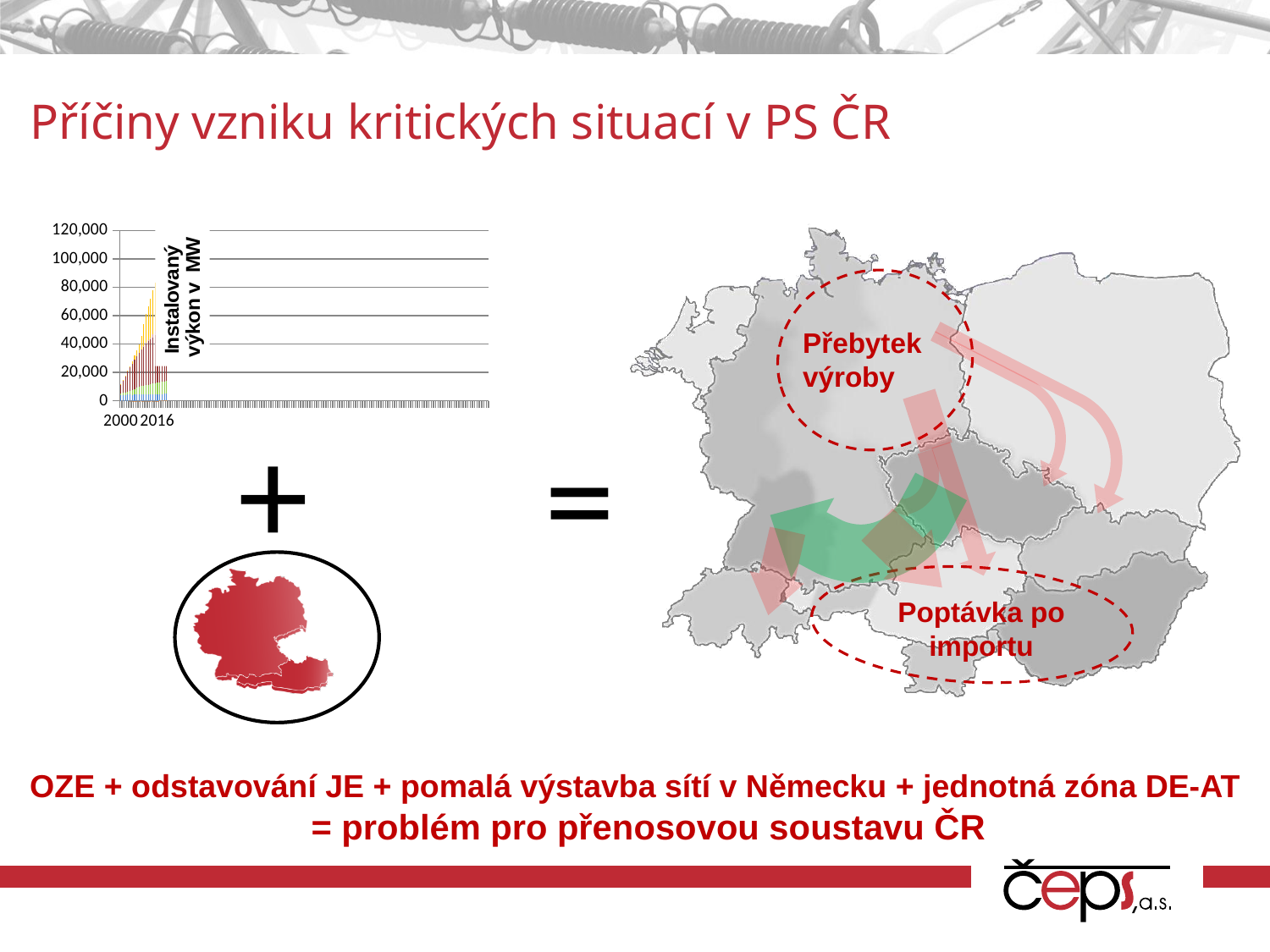
What kind of chart is shown on the left of the slide? bar chart How many tick labels are shown on the vertical axis of the chart? 7 What is the lowest tick value on the vertical axis of the chart? 0 Is the tallest bar in the chart greater or less than 40,000? greater Do the bar heights in the chart rise or fall from 2000 towards 2016? rise What is the label of the vertical axis of the chart? Instalovaný výkon v MW What is the highest value shown on the vertical axis of the chart? 120,000 Which two years are labelled on the horizontal axis of the chart? 2000 and 2016